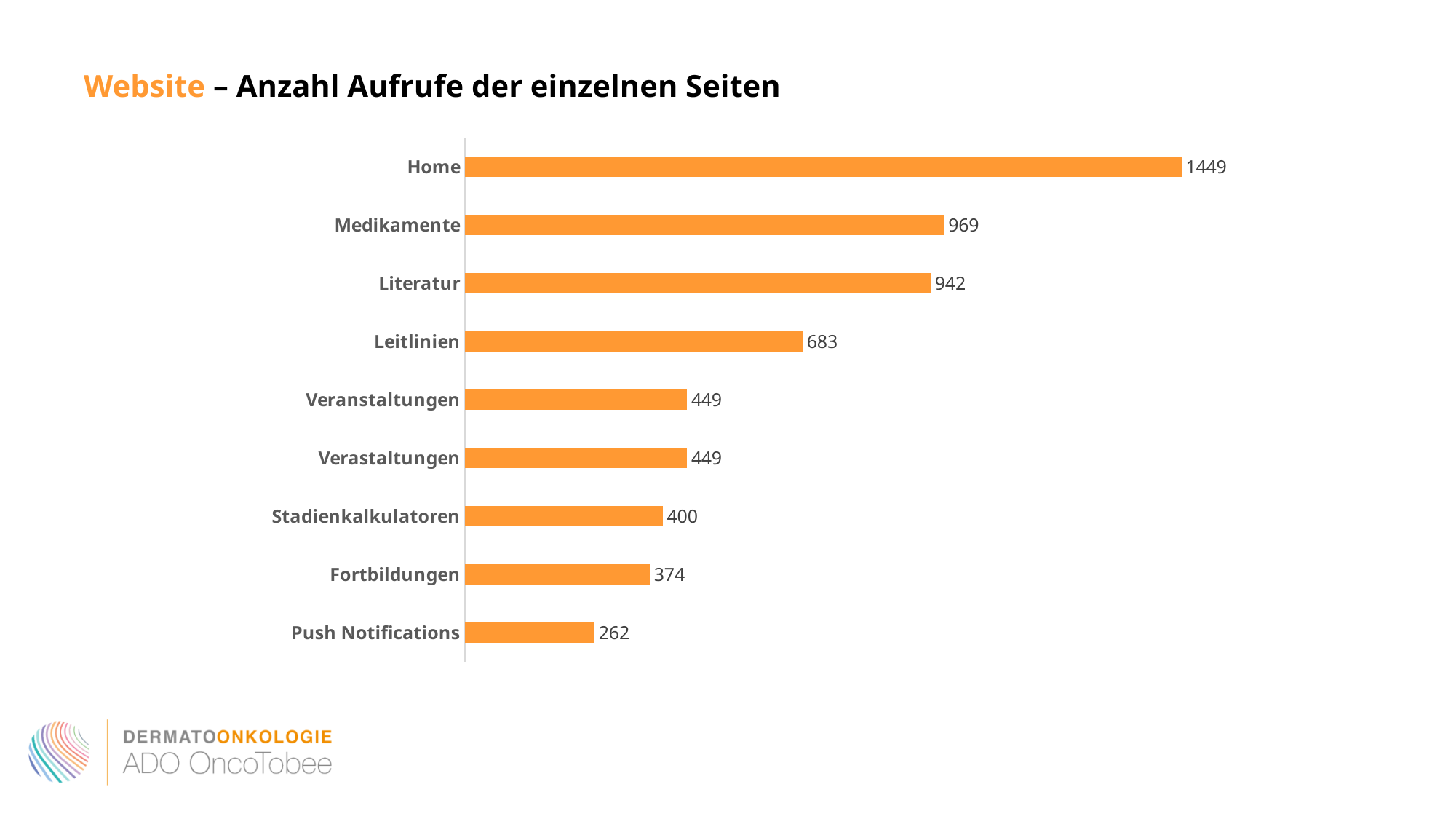
What is the difference between the values for Home and Medikamente? 480 How many categories are shown in the chart? 9 Which is larger, the value for Medikamente or the value for Literatur? Medikamente Which category has the highest value? Home What is the title of the slide? Website – Anzahl Aufrufe der einzelnen Seiten What kind of chart is shown on the slide? Bar chart What is the value for Push Notifications? 262 What is the difference between the values for Leitlinien and Fortbildungen? 309 What is the value for Home? 1449 What is the value for Leitlinien? 683 What is the value for Stadienkalkulatoren? 400 Which category has the lowest value? Push Notifications